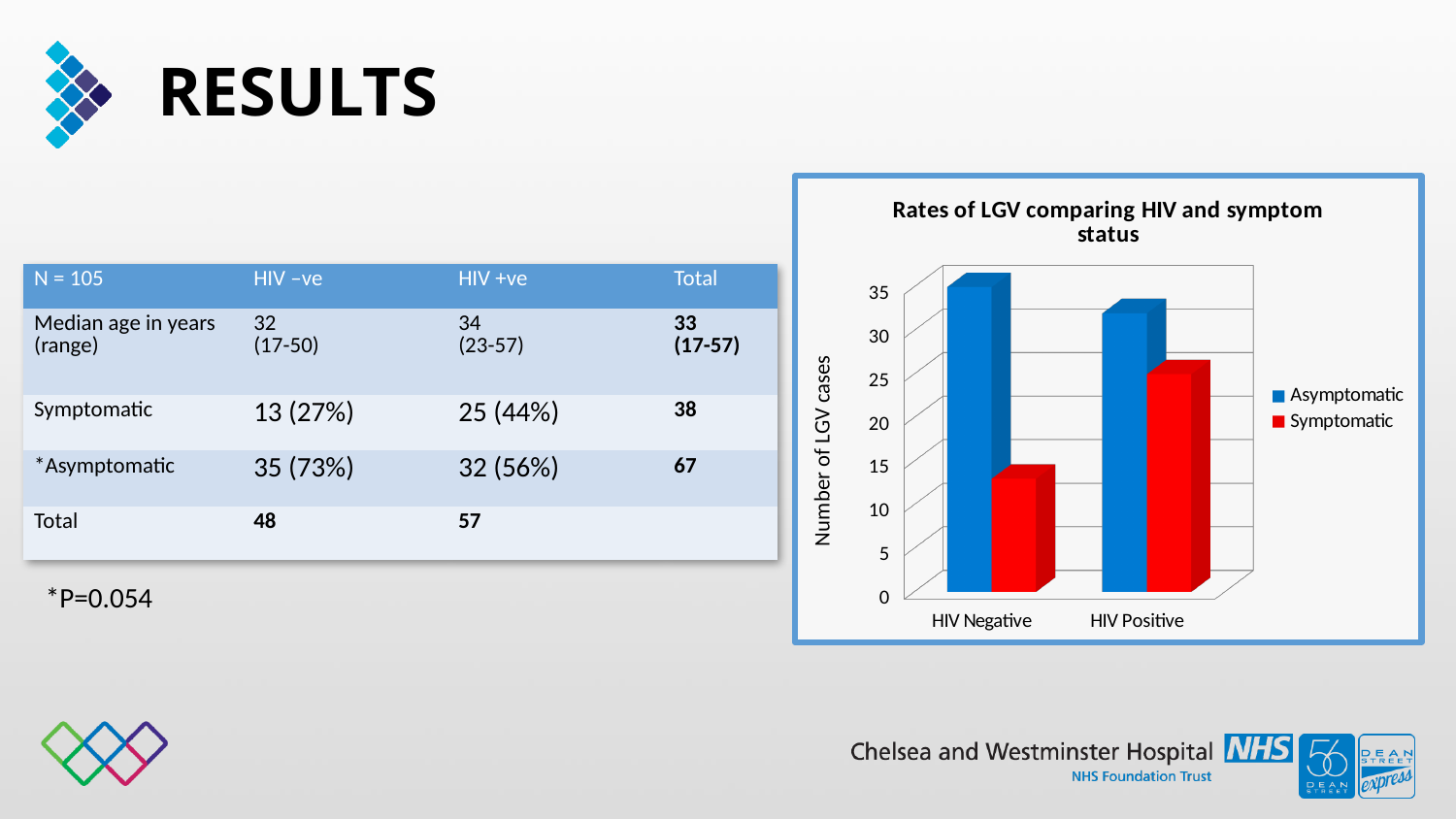
Which category has the larger Symptomatic value, HIV Negative or HIV Positive? HIV Positive Which bar in the chart is the tallest? Asymptomatic, HIV Negative For HIV Positive, which series has the larger value, Asymptomatic or Symptomatic? Asymptomatic Which bar in the chart is the shortest? Symptomatic, HIV Negative Is the Asymptomatic value for HIV Negative greater or less than 30? greater What is the title of the chart? Rates of LGV comparing HIV and symptom status Is the Symptomatic value for HIV Negative greater or less than 20? less What is the label of the vertical axis of the chart? Number of LGV cases How many categories are shown on the x axis of the chart? 2 How many series does the chart legend list? 2 Is the Symptomatic value for HIV Positive greater or less than 20? greater What type of chart is shown on the slide? bar chart